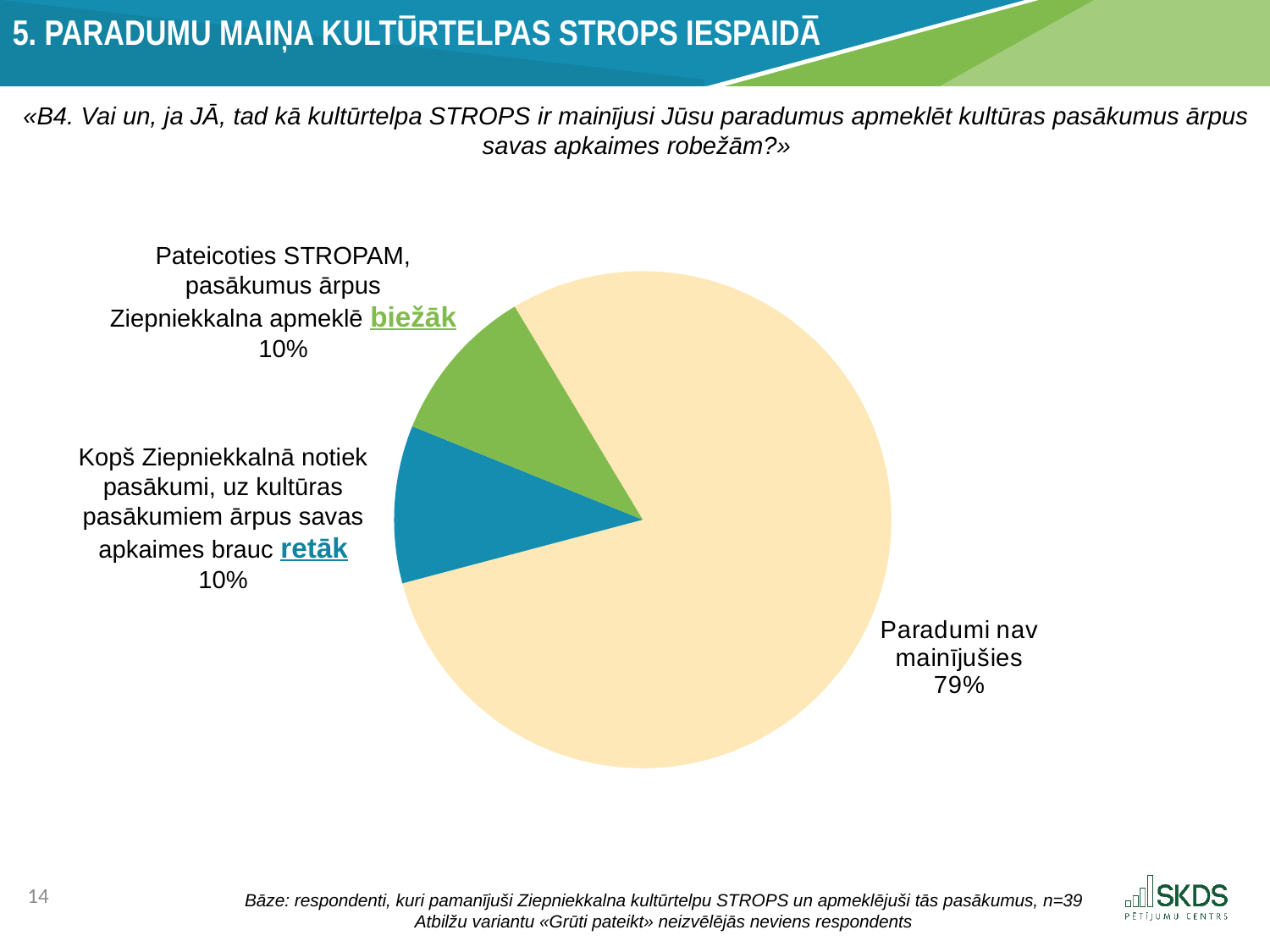
How many slices does the pie chart have? 3 What is the difference in percentage points between "Paradumi nav mainījušies" and the "biežāk" slice? 69 percentage points What share of respondents answered "Paradumi nav mainījušies"? 79% What is the combined share of the "biežāk" and "retāk" slices? 20% What percentage of respondents say they travel to cultural events outside their neighbourhood less often ("retāk")? 10% What kind of chart is shown on the slide? Pie chart Do the "biežāk" and "retāk" slices have the same share? Yes, both 10% What percentage of respondents say that thanks to STROPS they attend events outside Ziepniekkalns more often ("biežāk")? 10% Which is larger: the share for "Paradumi nav mainījušies" or the share for "retāk"? Paradumi nav mainījušies What colour is the "Paradumi nav mainījušies" slice? Light yellow What colour is the "retāk" slice? Blue Which answer option has the largest share of the pie? Paradumi nav mainījušies